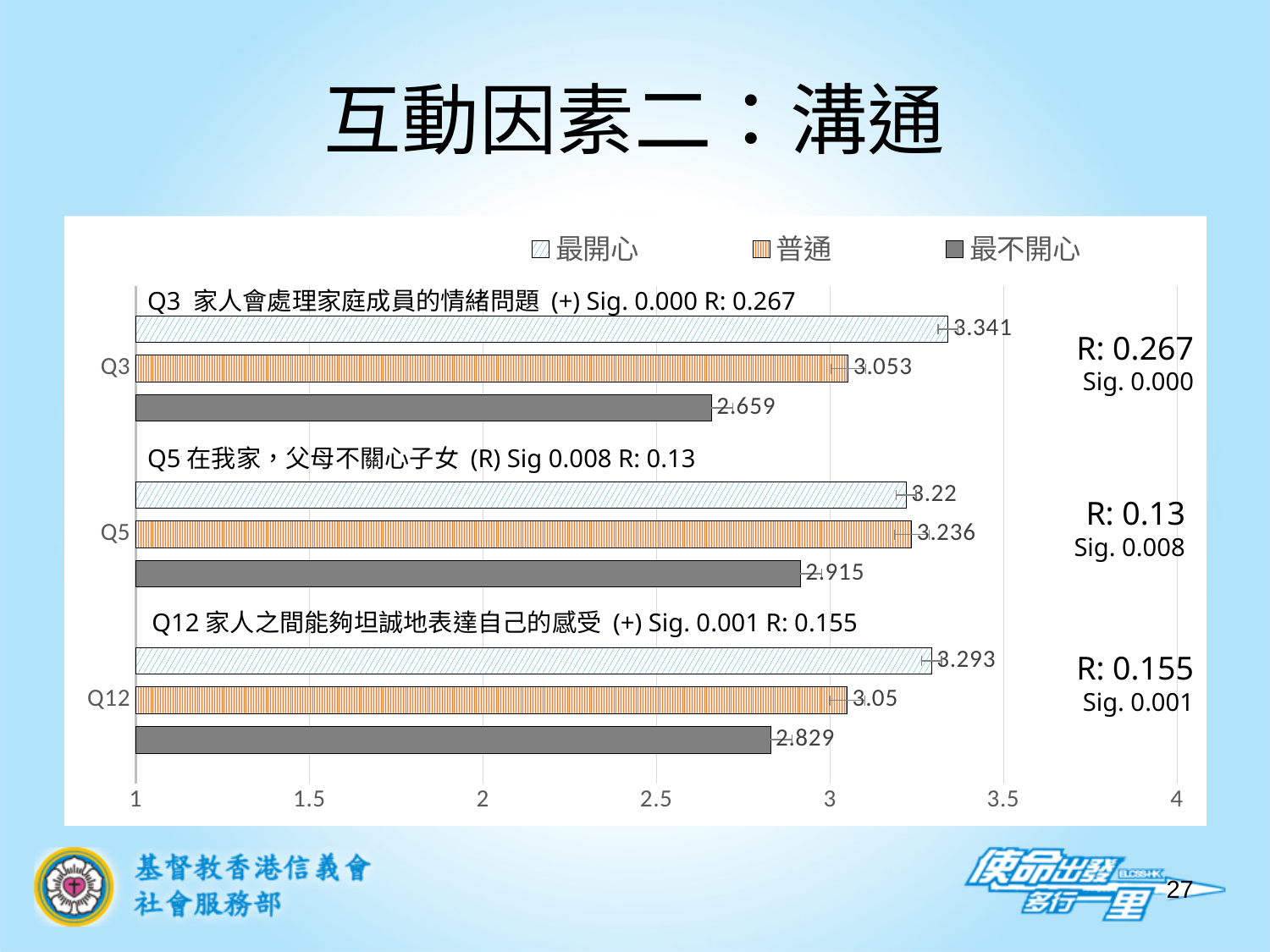
Is the value for 最不開心 in category Q12 greater or less than 3? less How many categories are shown on the chart? 3 How many series does the legend list? 3 In category Q12, which is larger: the value for 最開心 or the value for 最不開心? 最開心 What kind of chart is shown on the slide? bar chart What is the value for 普通 in category Q12? 3.05 What is the difference between the 最開心 and 最不開心 values in category Q3? 0.682 Which category has the highest value for the 最開心 series? Q3 What is the value for 最不開心 in category Q5? 2.915 Which category has the lowest value for the 最不開心 series? Q3 What is the title of the slide? 互動因素二：溝通 What is the value for 最開心 in category Q3? 3.341